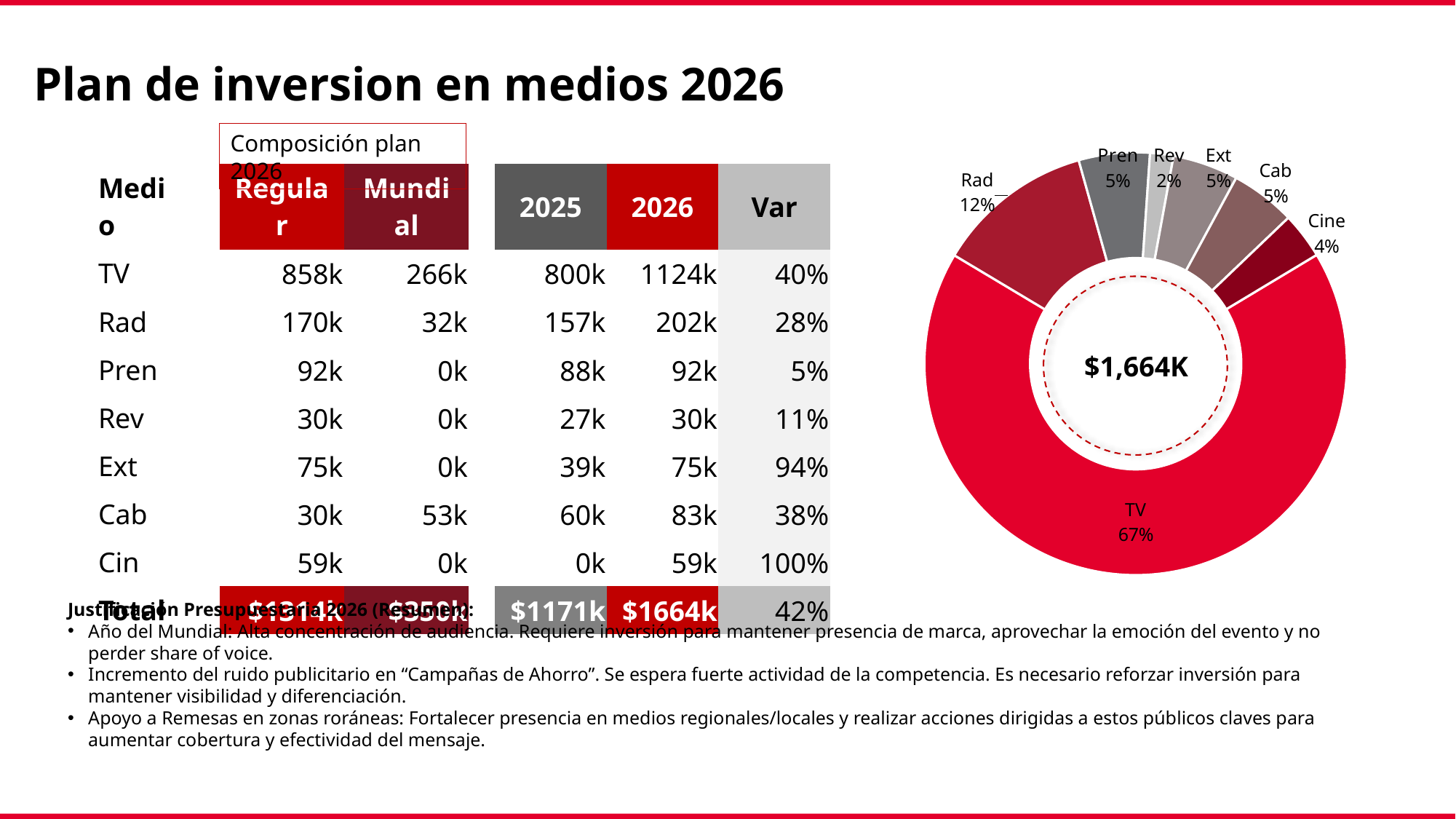
Which category has the largest slice in the pie chart? TV What total value is printed in the centre of the donut chart? $1,664K What share of the pie chart does Ext represent? 5% What share of the pie chart does TV represent? 67% Which category has the smallest slice in the pie chart? Rev How many slices does the pie chart have? 7 What share of the pie chart does Cine represent? 4% What share of the pie chart does Rev represent? 2% What share of the pie chart does Rad represent? 12% What is the difference in percentage points between the TV slice and the Rad slice in the pie chart? 55 What kind of chart is shown on the right side of the slide? Pie chart (donut) In the pie chart, which is larger, the Rad slice or the Pren slice? Rad